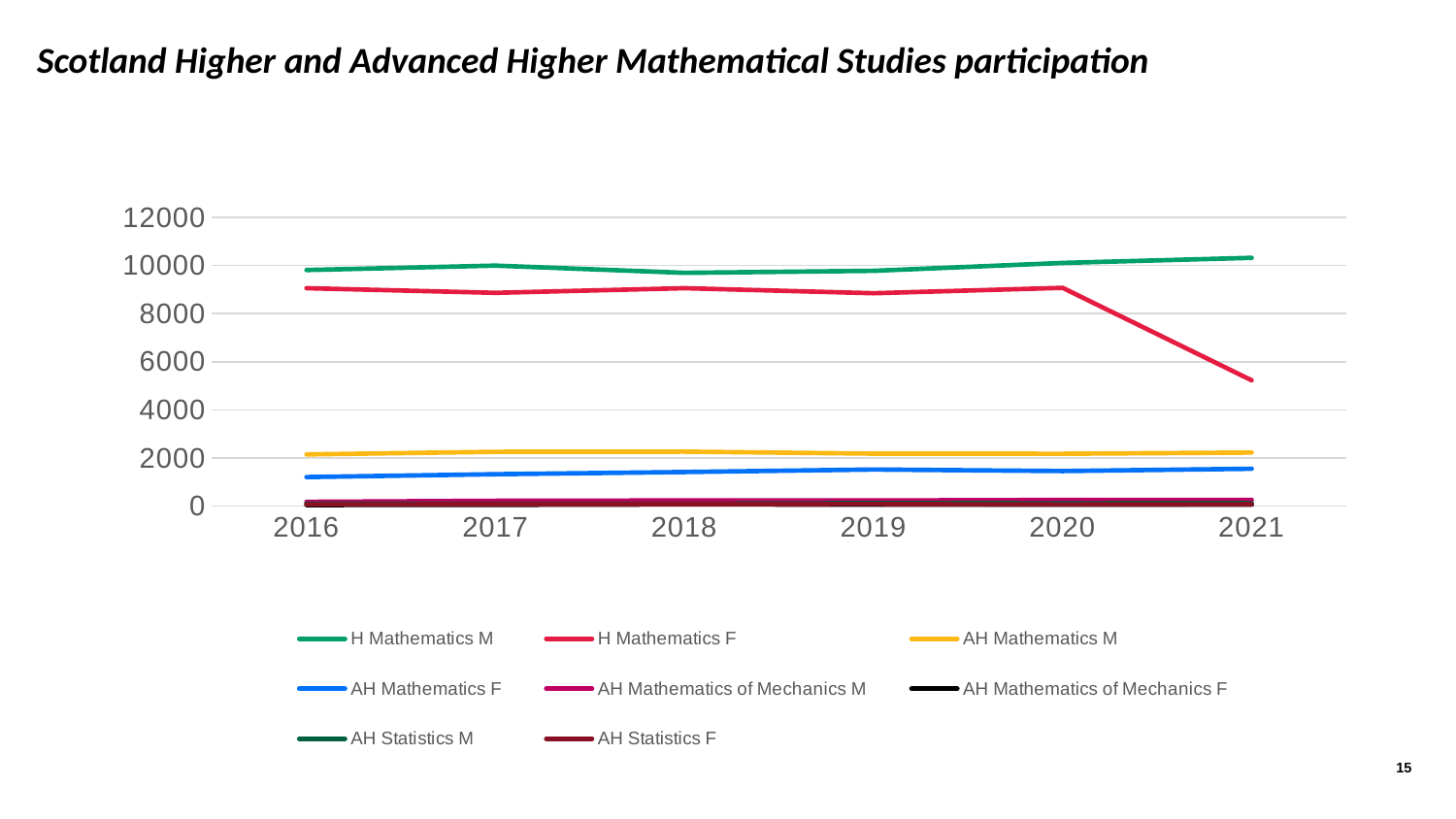
In which year is the value for H Mathematics F lowest? 2021 Is the value for H Mathematics M in 2016 greater or less than 8000? greater How many years are shown along the x axis? 6 Which series has the highest value in 2021? H Mathematics M Which is larger in 2016, AH Mathematics M or AH Mathematics F? AH Mathematics M Is the value for AH Mathematics F in 2019 greater or less than 2000? less What is the title of the slide? Scotland Higher and Advanced Higher Mathematical Studies participation Which is larger in 2021, H Mathematics M or H Mathematics F? H Mathematics M Is the value for H Mathematics F in 2021 greater or less than 6000? less How many series does the legend list? 8 Does the value for H Mathematics F rise or fall from 2020 to 2021? fall What kind of chart is shown on the slide? Line chart